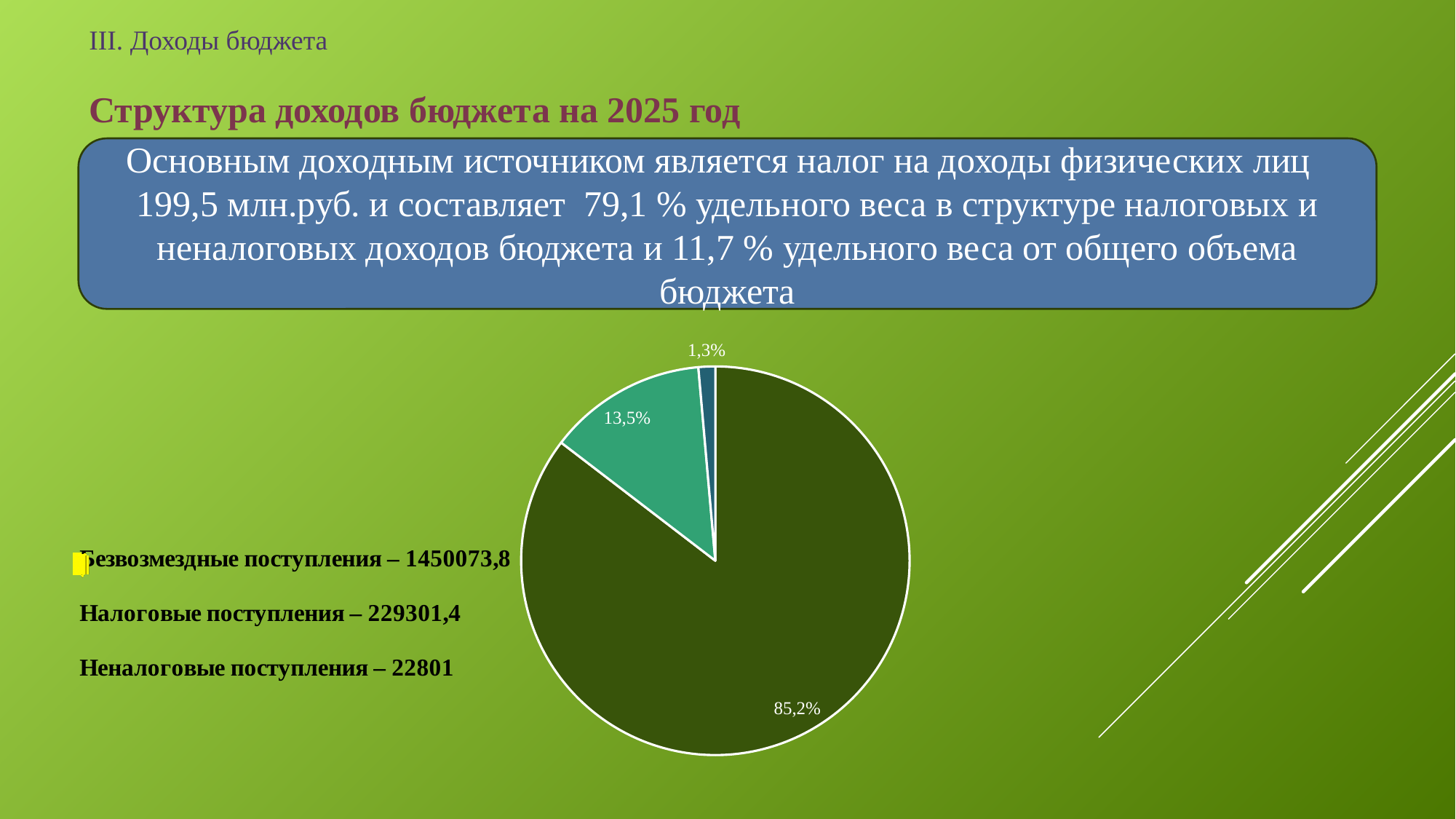
What value is given for Неналоговые поступления? 22801 What is the percentage shown on the largest slice of the pie chart? 85,2% What share of the pie does the largest category, Безвозмездные поступления, take? 85,2% What is the title of the chart section on the slide? Структура доходов бюджета на 2025 год What is the difference in percentage points between the 85,2% slice and the 13,5% slice? 71,7 What is the difference in percentage points between the 13,5% slice and the 1,3% slice? 12,2 How many slices does the pie chart have? 3 What is the percentage shown on the smallest slice of the pie chart? 1,3% What kind of chart is shown on the slide? pie chart What value is given for Безвозмездные поступления? 1450073,8 Which is larger, Налоговые поступления or Неналоговые поступления? Налоговые поступления What value is given for Налоговые поступления? 229301,4